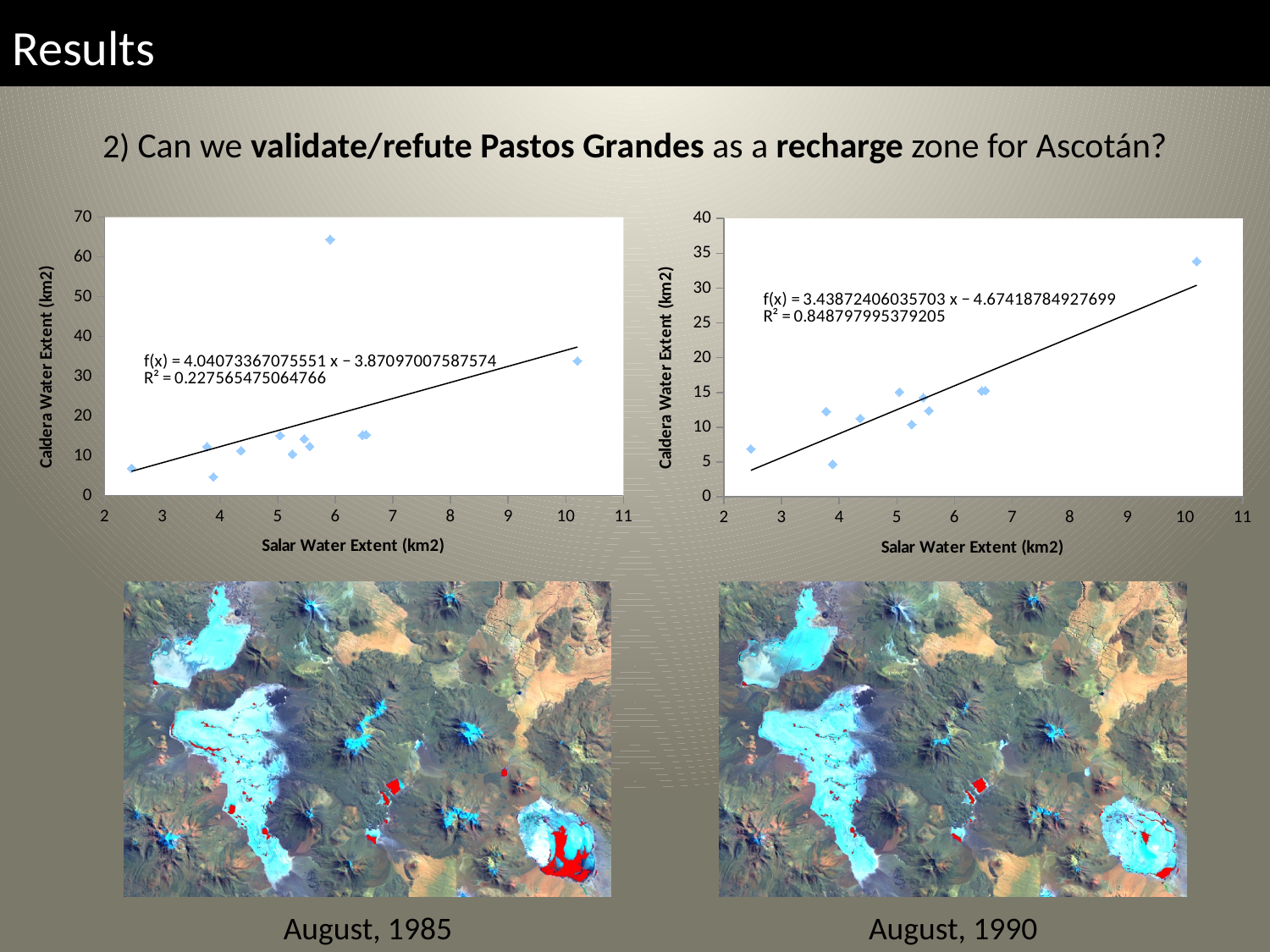
On the right chart, what R² value is printed for the trendline? 0.848797995379205 On the left chart, does the trendline rise or fall as Salar Water Extent increases? rise What is the label of the y axis on the right chart? Caldera Water Extent (km2) On the left chart, is the highest plotted Caldera Water Extent value greater or less than 60? greater What is the label of the x axis on the left chart? Salar Water Extent (km2) On the left chart, what R² value is printed for the trendline? 0.227565475064766 Which chart has the larger R² value, the left chart or the right chart? the right chart On the left chart, what is the trendline equation printed on the chart? f(x) = 4.04073367075551 x − 3.87097007587574 On the right chart, what is the trendline equation printed on the chart? f(x) = 3.43872406035703 x − 4.67418784927699 What kind of chart is the right chart on the slide? scatter chart On the right chart, is the highest plotted Caldera Water Extent value greater or less than 30? greater What kind of chart is the left chart on the slide? scatter chart